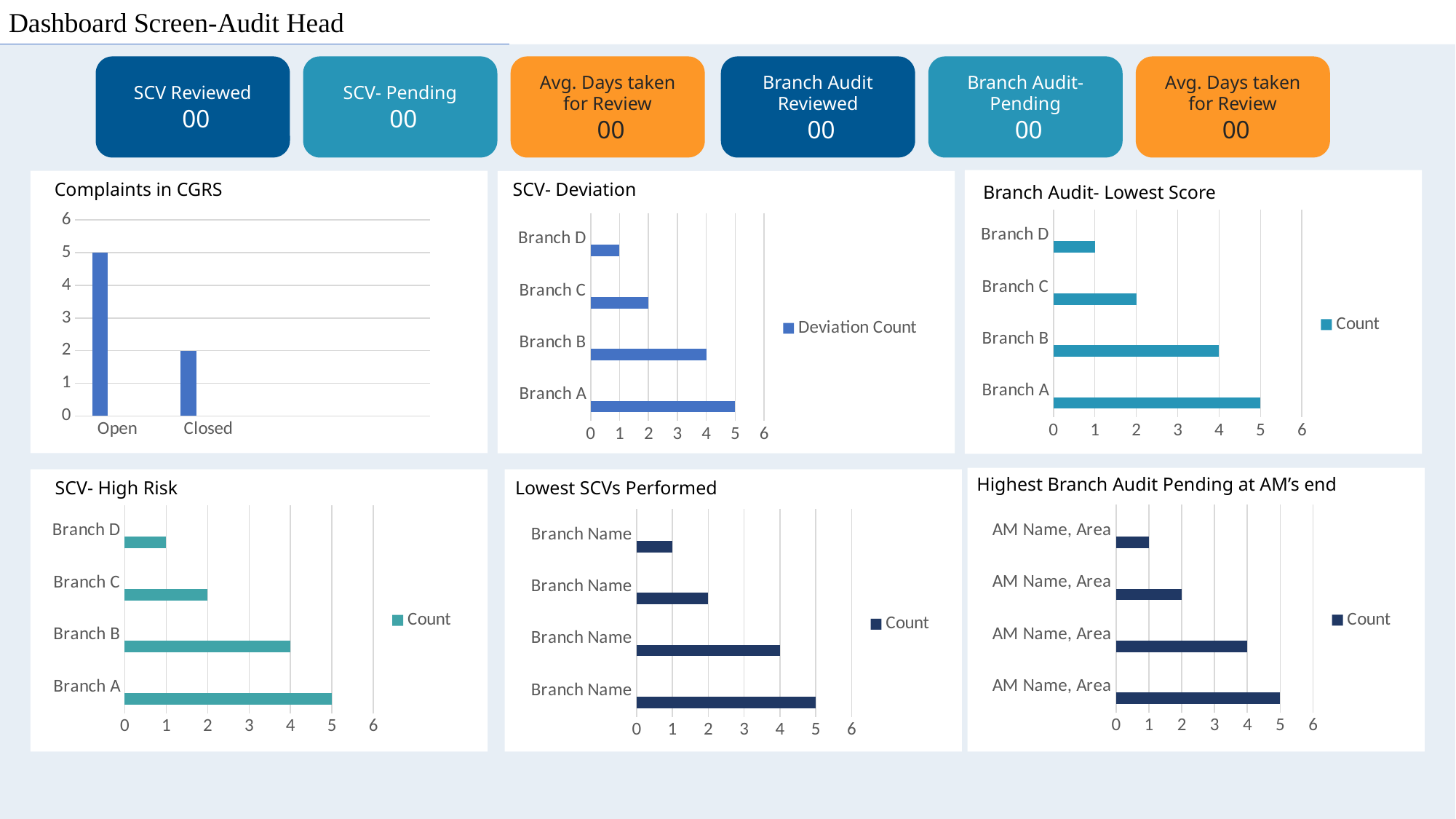
In the 'SCV- Deviation' chart, what is the Deviation Count for Branch B? 4 In the 'SCV- Deviation' chart, which branch has the lowest Deviation Count? Branch D In the 'Branch Audit- Lowest Score' chart, what is the Count for Branch C? 2 What kind of chart is 'Highest Branch Audit Pending at AM's end'? Bar chart In the 'SCV- High Risk' chart, what is the Count for Branch A? 5 In the 'Complaints in CGRS' chart, what is the value for Open? 5 In the 'Branch Audit- Lowest Score' chart, is the Count for Branch A greater or less than 4? greater How many categories are shown in the 'Lowest SCVs Performed' chart? 4 In the 'SCV- Deviation' chart, which branch has the highest Deviation Count? Branch A In the 'SCV- High Risk' chart, which is larger, the Count for Branch B or Branch C? Branch B In the 'Complaints in CGRS' chart, what is the value for Closed? 2 In the 'Complaints in CGRS' chart, what is the difference between Open and Closed? 3